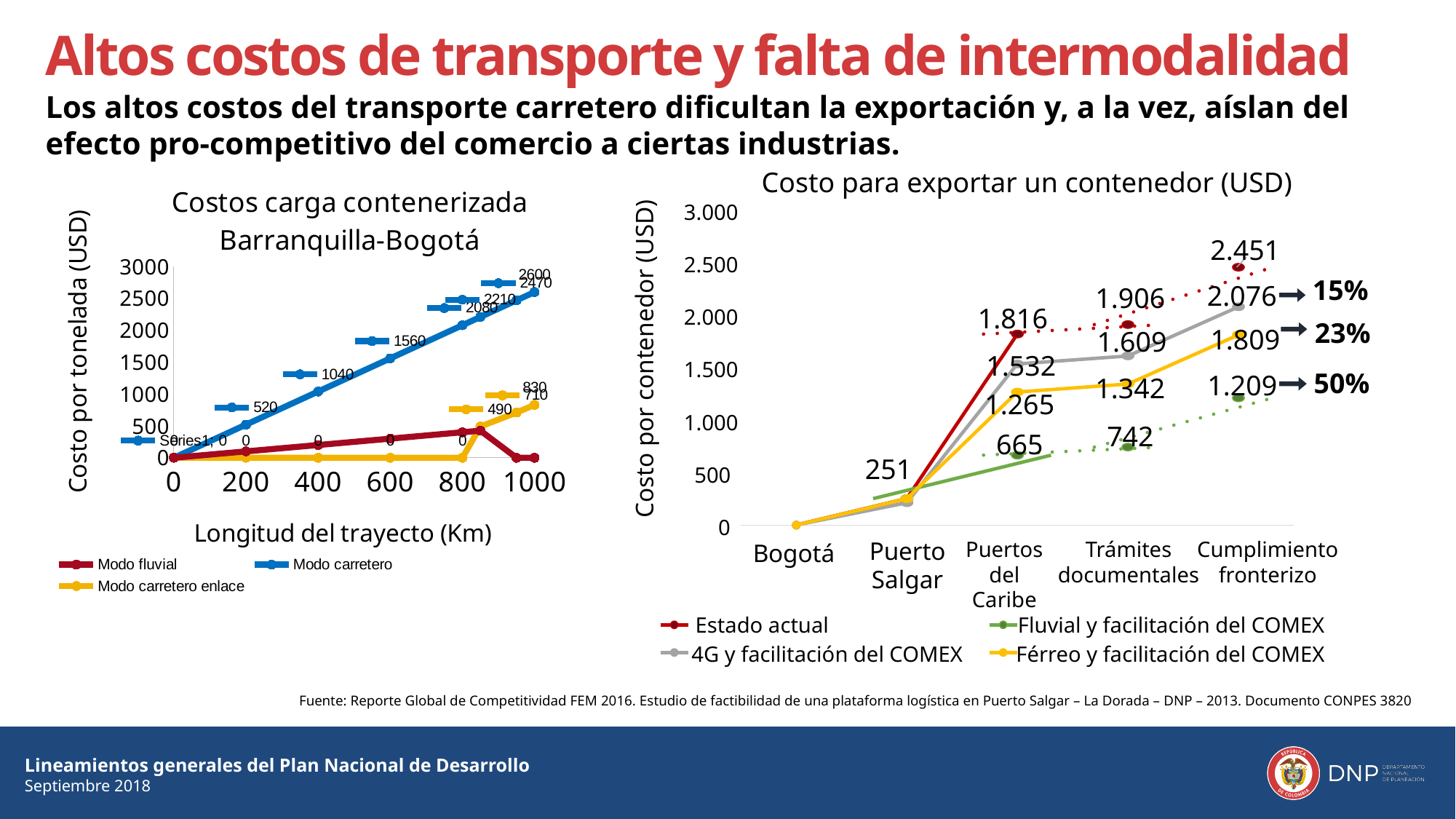
On the chart 'Costo para exportar un contenedor (USD)', does the 'Estado actual' series rise or fall from Bogotá to Cumplimiento fronterizo? rise What kind of chart is 'Costos carga contenerizada Barranquilla-Bogotá'? line chart On the chart 'Costo para exportar un contenedor (USD)', what is the value of 'Fluvial y facilitación del COMEX' at 'Puertos del Caribe'? 665 On the chart 'Costo para exportar un contenedor (USD)', what is the value of 'Estado actual' at 'Cumplimiento fronterizo'? 2.451 On the chart 'Costo para exportar un contenedor (USD)', how many series does the legend list? 4 On the chart 'Costos carga contenerizada Barranquilla-Bogotá', how many series does the legend list? 3 On the chart 'Costo para exportar un contenedor (USD)', which series has the highest value at 'Cumplimiento fronterizo'? Estado actual On the chart 'Costo para exportar un contenedor (USD)', what is the value of 'Férreo y facilitación del COMEX' at 'Trámites documentales'? 1.342 On the chart 'Costo para exportar un contenedor (USD)', how many categories are shown on the x axis? 5 On the chart 'Costo para exportar un contenedor (USD)', which series has the lowest value at 'Cumplimiento fronterizo'? Fluvial y facilitación del COMEX On the chart 'Costos carga contenerizada Barranquilla-Bogotá', what is the highest labelled value of the 'Modo carretero' series? 2600 On the chart 'Costo para exportar un contenedor (USD)', what is the difference between 'Estado actual' and 'Fluvial y facilitación del COMEX' at 'Cumplimiento fronterizo'? 1.242